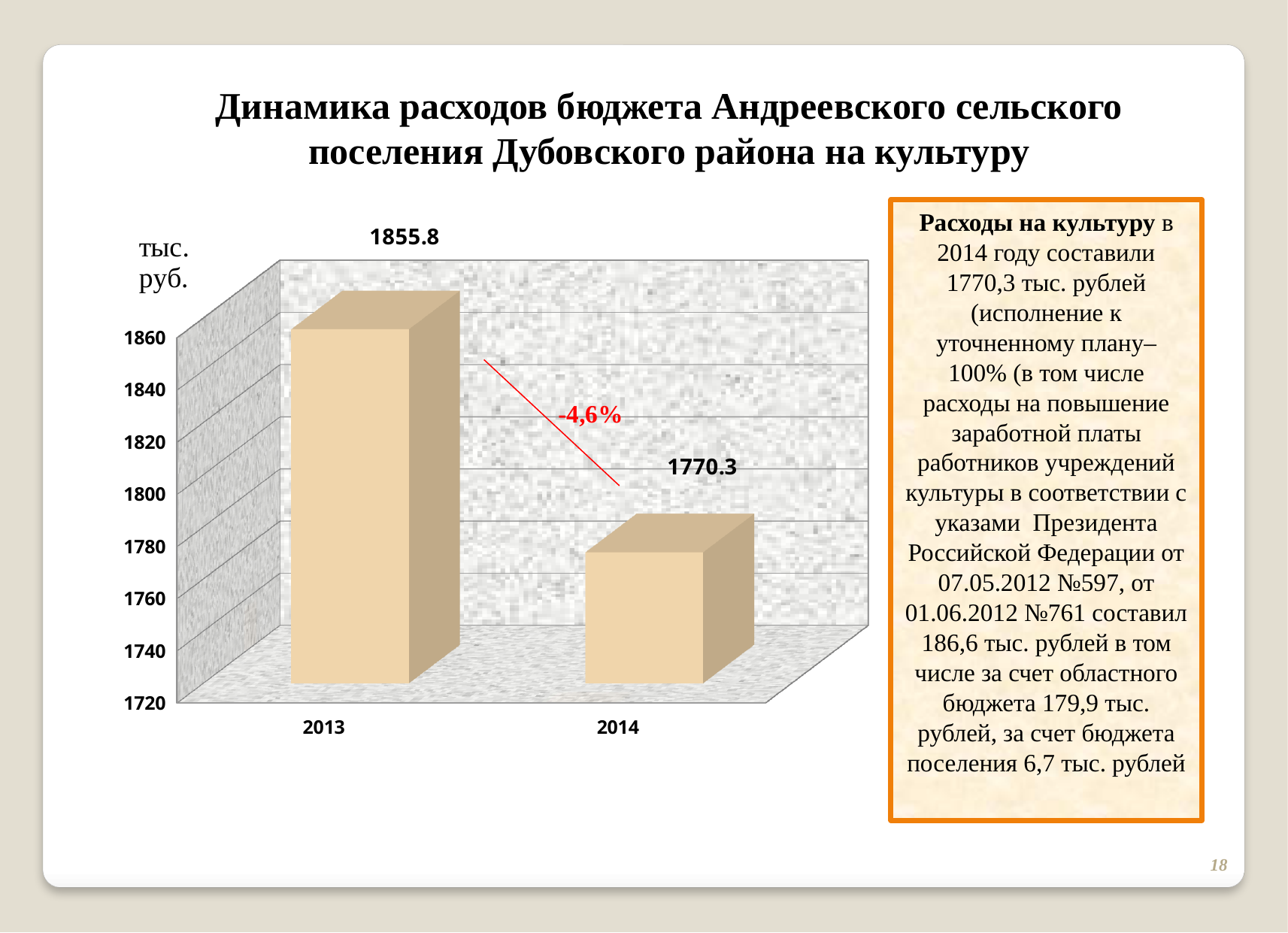
Is the value for 2013 greater or less than 1840? greater Do the values rise or fall from 2013 to 2014? fall Is the value for 2013 larger or smaller than the value for 2014? larger What is the value for 2013? 1855.8 What percentage change is annotated in red between the two bars? -4,6% What is the value for 2014? 1770.3 Is the value for 2014 greater or less than 1800? less What kind of chart is shown on the slide? bar chart How many years are shown on the chart? 2 Which year has the lower value? 2014 Which year has the higher value? 2013 What is the difference between the 2013 and 2014 values? 85.5